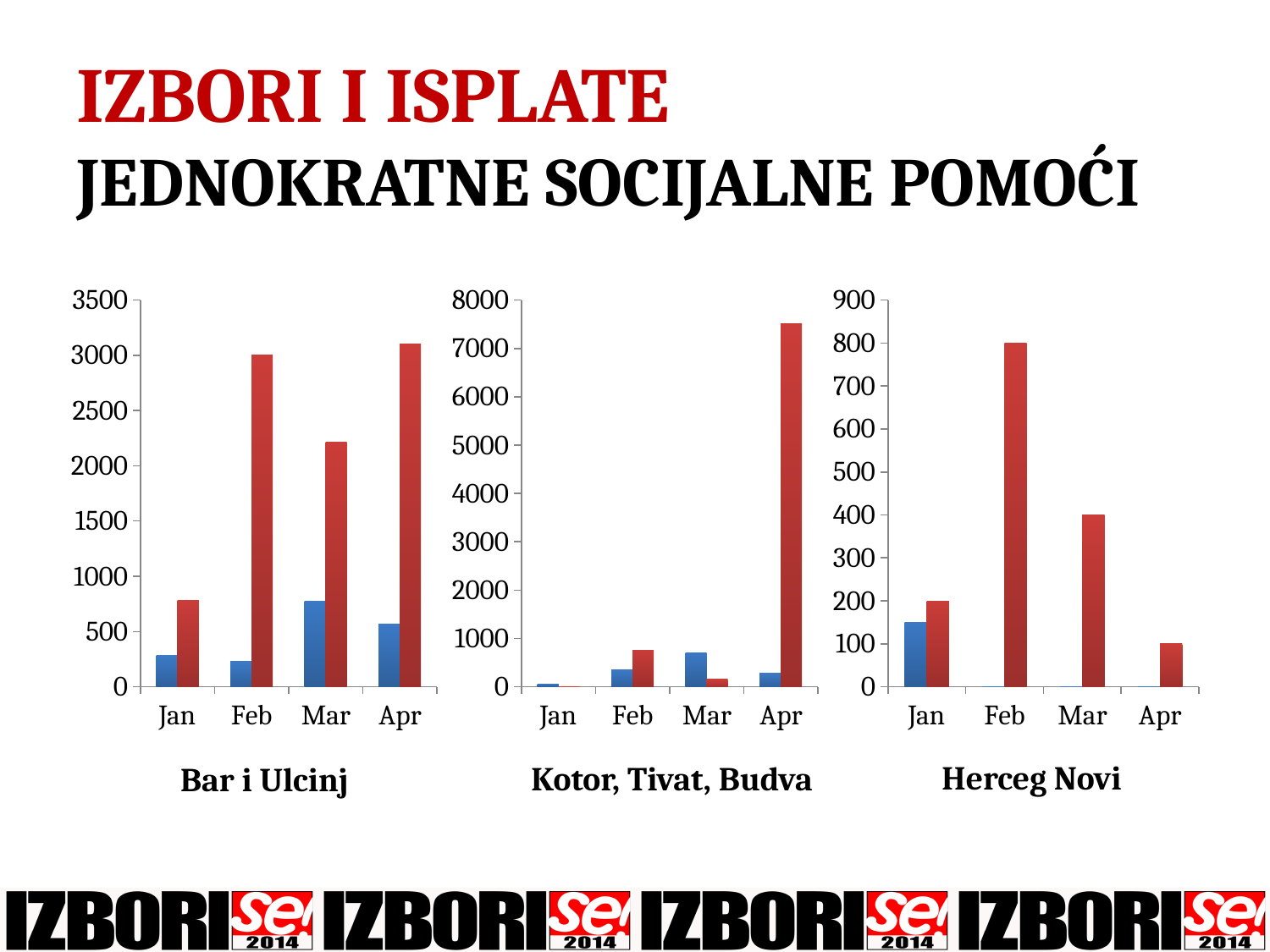
In the Herceg Novi chart, what is the value of the red bar for Apr? 100 In the Bar i Ulcinj chart, is the red bar for Mar greater or less than 2000? greater In the Herceg Novi chart, what is the value of the red bar for Mar? 400 What kind of chart is the Herceg Novi chart? bar chart In the Herceg Novi chart, what is the value of the red bar for Feb? 800 In the Herceg Novi chart, what is the difference between the red bars for Feb and Mar? 400 In the Herceg Novi chart, which month has the highest red bar? Feb In the Herceg Novi chart, do the red bars rise or fall from Feb to Apr? fall How many months are shown on the x axis of the Bar i Ulcinj chart? 4 In the Kotor, Tivat, Budva chart, is the red bar for Apr greater or less than 7000? greater In the Bar i Ulcinj chart, which is larger for Jan, the blue bar or the red bar? the red bar In the Kotor, Tivat, Budva chart, which month has the highest red bar? Apr